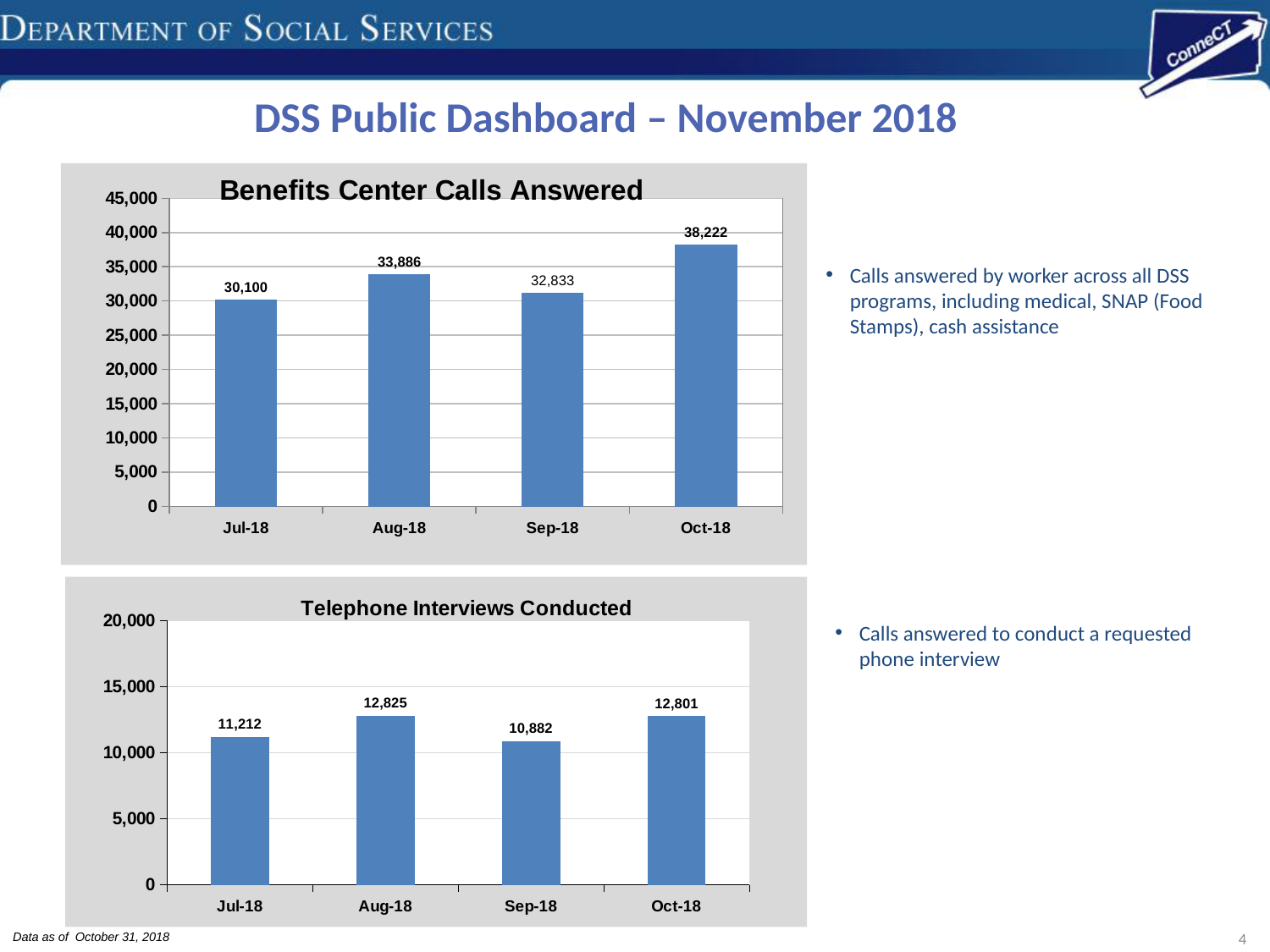
In the Benefits Center Calls Answered chart, which is larger, Aug-18 or Sep-18? Aug-18 In the Benefits Center Calls Answered chart, what is the value for Oct-18? 38,222 In the Telephone Interviews Conducted chart, which month has the highest value? Aug-18 What is the title of the bottom chart on the slide? Telephone Interviews Conducted In the Telephone Interviews Conducted chart, what is the difference between Aug-18 and Oct-18? 24 In the Benefits Center Calls Answered chart, what is the difference between Oct-18 and Jul-18? 8,122 What kind of chart is the Benefits Center Calls Answered chart? Bar chart In the Telephone Interviews Conducted chart, is the value for Jul-18 greater or less than 10,000? greater In the Telephone Interviews Conducted chart, what is the value for Sep-18? 10,882 In the Benefits Center Calls Answered chart, which month has the lowest value? Jul-18 In the Benefits Center Calls Answered chart, how many months are shown? 4 In the Telephone Interviews Conducted chart, what is the value for Jul-18? 11,212